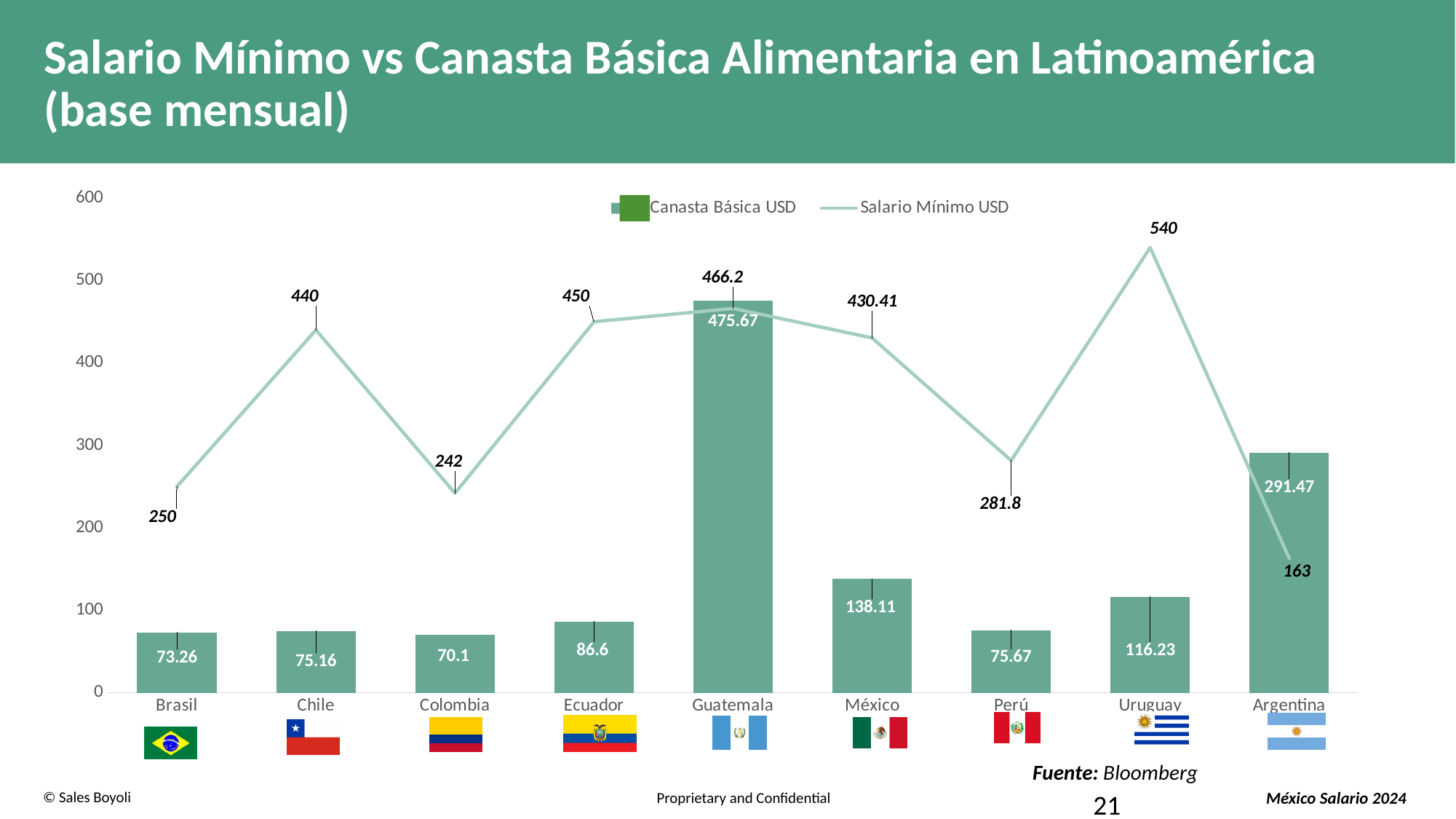
What is the Salario Mínimo USD value for Uruguay? 540 Which country has the highest Canasta Básica USD value? Guatemala What is the difference between the Salario Mínimo USD values for Chile and Colombia? 198 For Argentina, how much larger is the Canasta Básica USD value than the Salario Mínimo USD value? 128.47 How many countries are shown on the x axis of the chart? 9 For Guatemala, which is larger: the Canasta Básica USD value or the Salario Mínimo USD value? Canasta Básica USD What is the Canasta Básica USD value for México? 138.11 What kind of chart is shown on the slide? A bar chart combined with a line chart Which country has the lowest Salario Mínimo USD value? Argentina Which country has the lowest Canasta Básica USD value? Colombia What is the Salario Mínimo USD value for Perú? 281.8 How many series does the chart legend list? 2